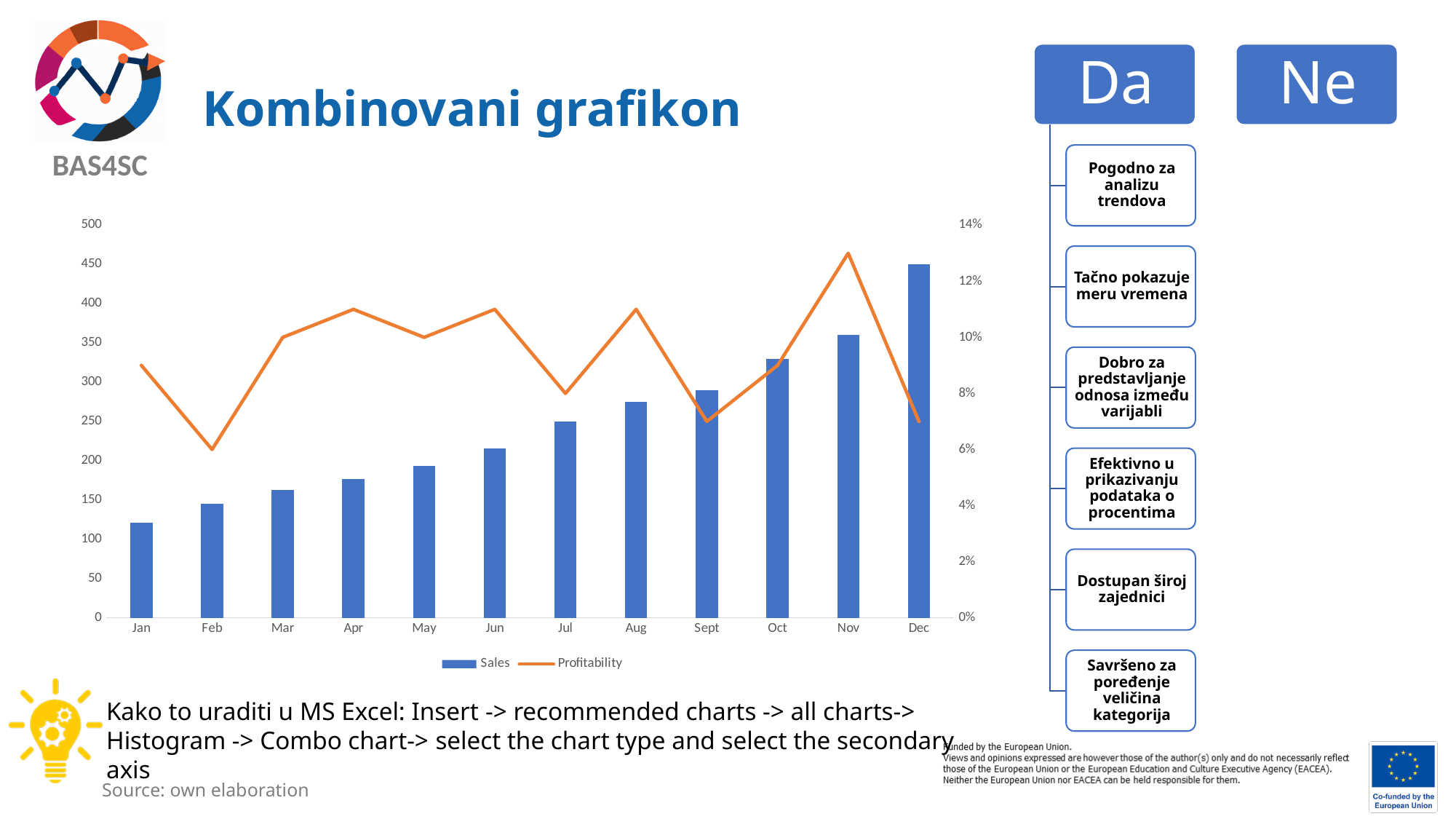
Do the Sales bars generally rise or fall from Jan to Dec? Rise Which month has the lowest Profitability value? Feb Is the Profitability value for Nov greater or less than 12%? greater Is the Sales value for Dec greater or less than 400? greater How many months are shown on the x axis of the chart? 12 Is the Sales value for Jan greater or less than 150? less Which month has the highest Profitability value? Nov Which month has the highest Sales bar? Dec How many series does the chart's legend list? 2 What kind of chart is shown on the slide? A combination bar and line chart Which month has the lowest Sales bar? Jan Which series is drawn as a line in the chart? Profitability